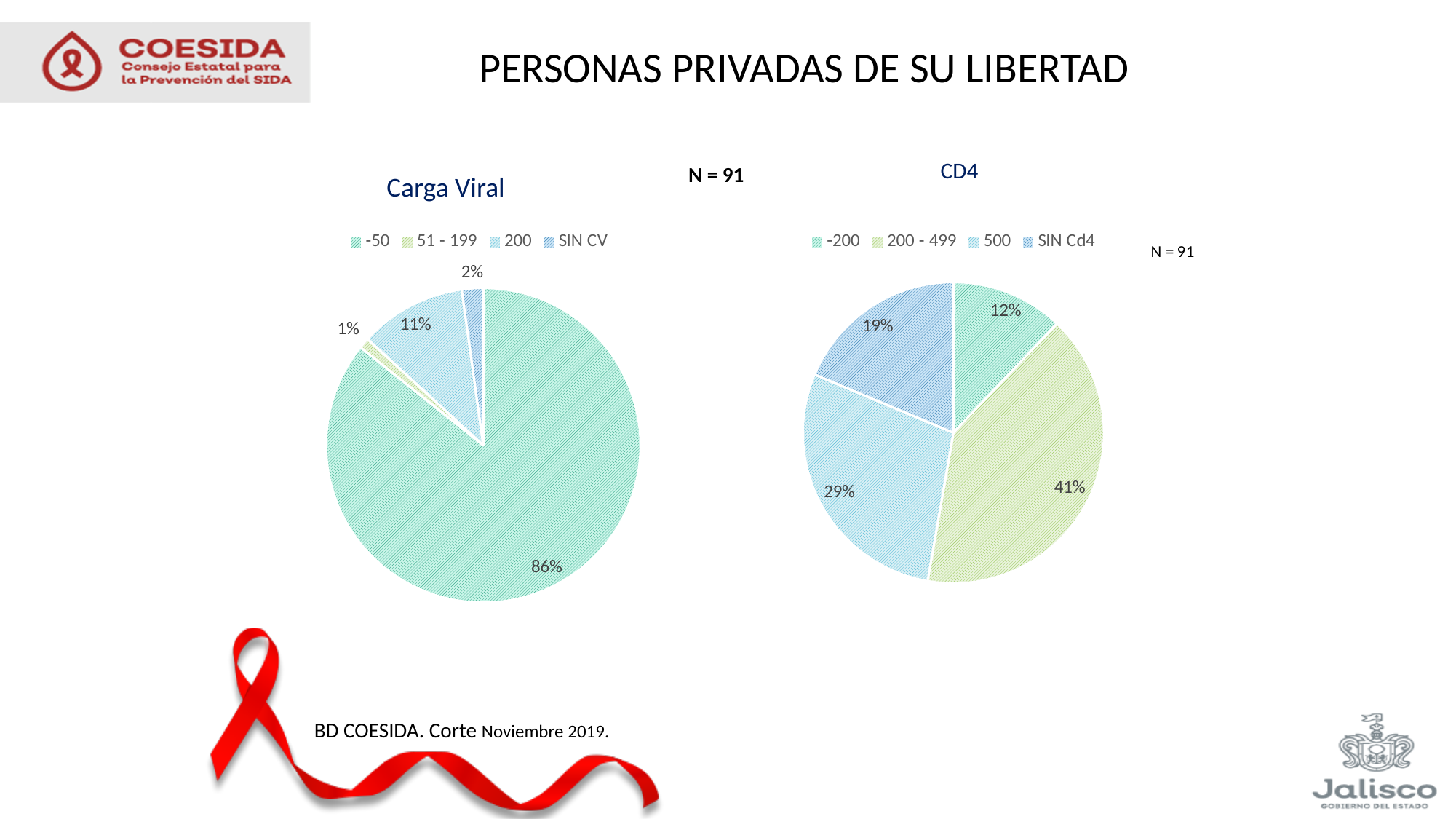
In the CD4 pie chart, which is larger, the 500 slice or the SIN Cd4 slice? 500 How many categories does the legend of the Carga Viral chart list? 4 In the Carga Viral pie chart, what share does the SIN CV slice have? 2% In the CD4 pie chart, what is the difference between the 500 slice and the -200 slice? 17% In the CD4 pie chart, what share does the 200 - 499 slice have? 41% In the CD4 pie chart, which category has the smallest share? -200 In the Carga Viral pie chart, which category has the smallest share? 51 - 199 In the Carga Viral pie chart, what share does the -50 slice have? 86% In the CD4 pie chart, what share does the SIN Cd4 slice have? 19% In the CD4 pie chart, which category has the largest share? 200 - 499 What type of chart is the CD4 chart? Pie chart In the Carga Viral pie chart, what share does the 200 slice have? 11%